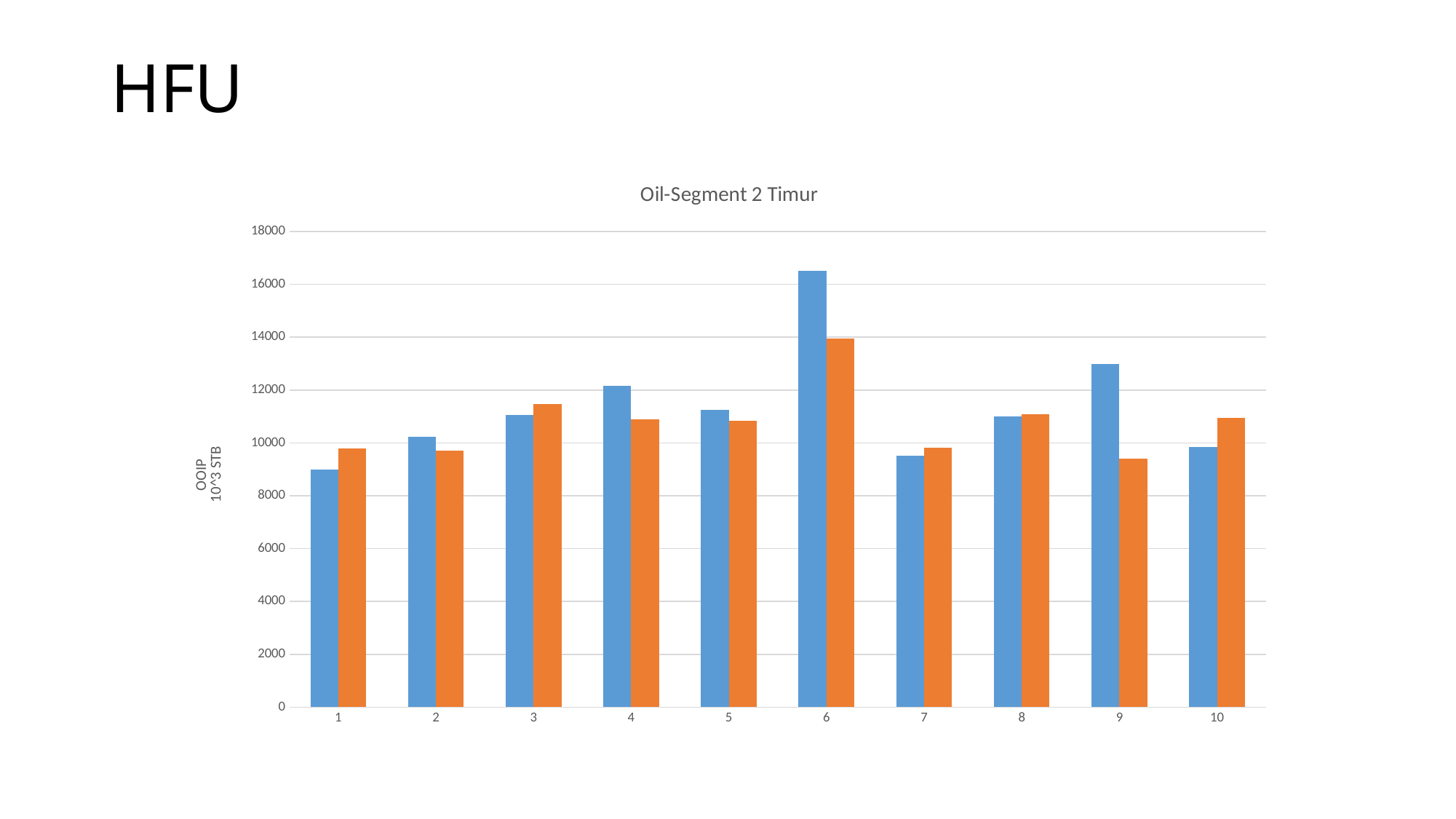
For category 9, which bar is taller, the blue one or the orange one? blue Which category has the highest blue bar? 6 What kind of chart is shown on the slide? bar chart Which category has the lowest blue bar? 1 What is the title of the chart? Oil-Segment 2 Timur Is the value of the blue bar for category 1 greater or less than 10000? less For category 1, which bar is taller, the blue one or the orange one? orange What is the label on the vertical axis of the chart? OOIP 10^3 STB How many categories are shown along the x axis of the chart? 10 Is the value of the orange bar for category 9 greater or less than 10000? less Which category has the highest orange bar? 6 Is the value of the blue bar for category 6 greater or less than 16000? greater